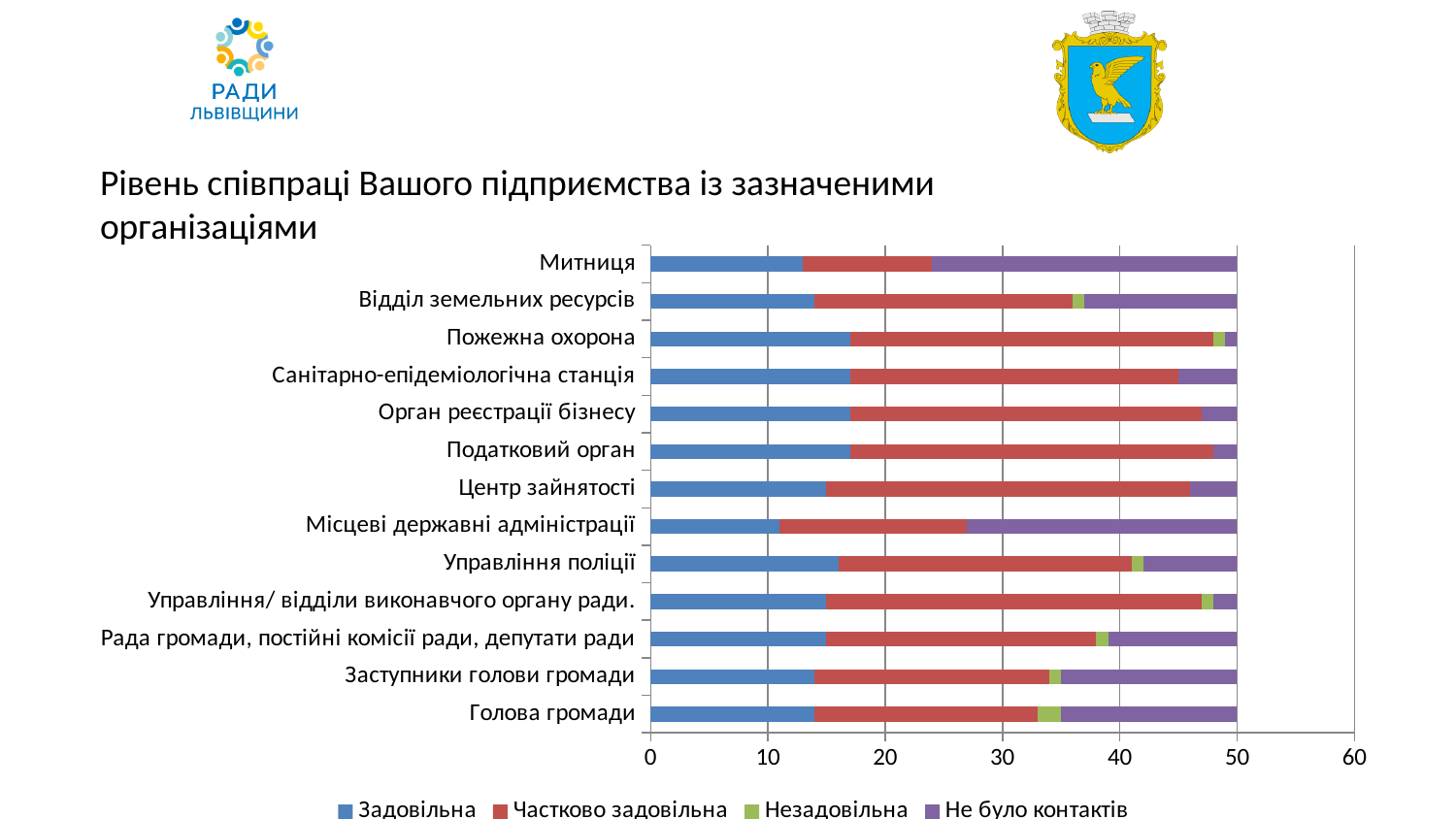
What is the title of the chart? Рівень співпраці Вашого підприємства із зазначеними організаціями Which category has the smallest Задовільна value? Місцеві державні адміністрації What is the total of the stacked bar for Митниця? 50 How many series does the legend list? 4 Is the Задовільна value for Пожежна охорона greater or less than 10? greater Which has the larger Задовільна value: Пожежна охорона or Місцеві державні адміністрації? Пожежна охорона Is the Задовільна value for Митниця greater or less than 20? less What kind of chart is shown on the slide? bar chart How many organisations (categories) are plotted on the chart? 13 What are the four legend entries of the chart? Задовільна, Частково задовільна, Незадовільна, Не було контактів Is the Задовільна value for Місцеві державні адміністрації greater or less than 20? less What is the total of the stacked bar for Голова громади? 50